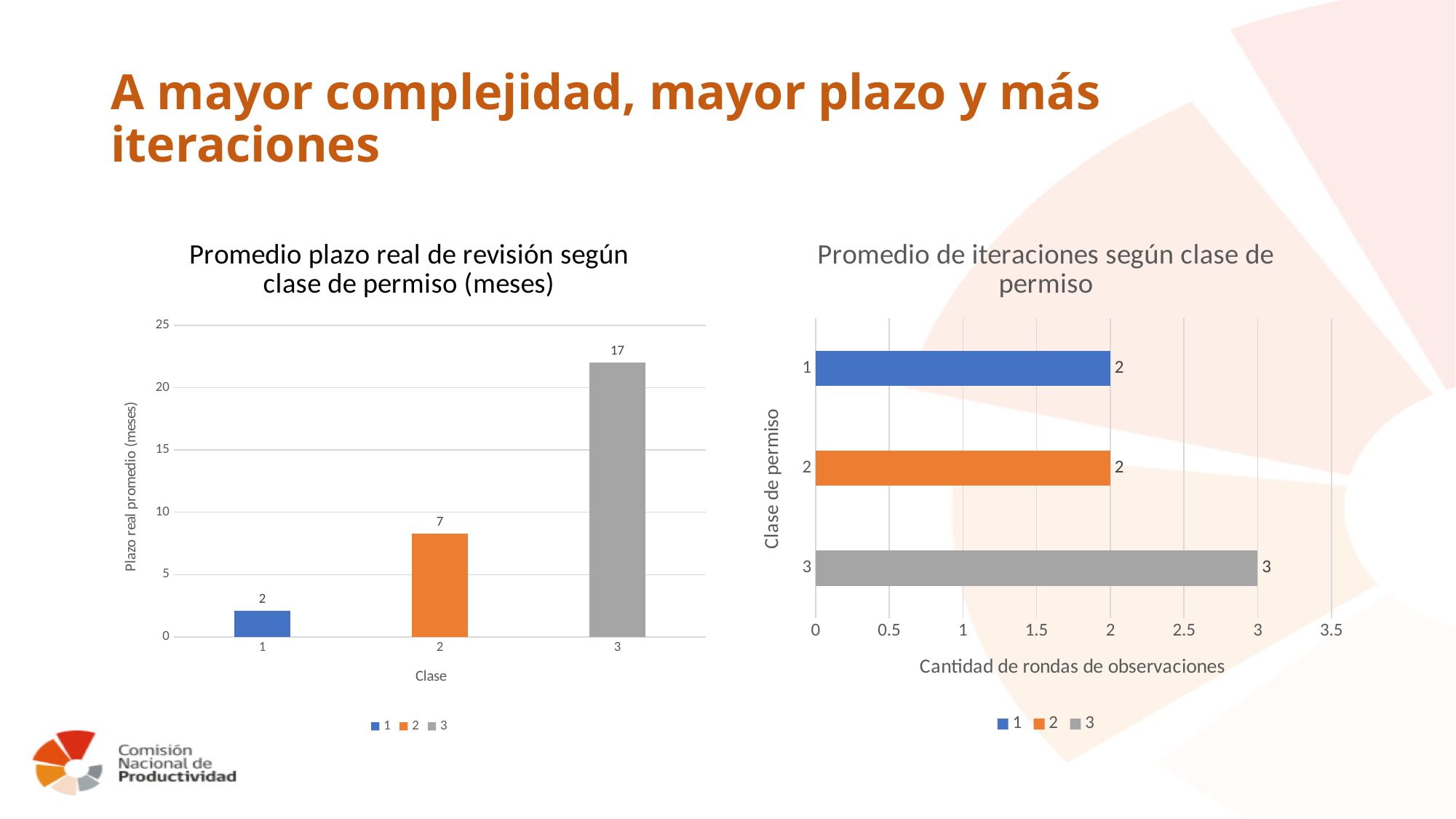
In the right chart, 'Promedio de iteraciones según clase de permiso', how many bars are plotted? 3 In the right chart, 'Promedio de iteraciones según clase de permiso', which clase de permiso has the highest value? 3 In the right chart, 'Promedio de iteraciones según clase de permiso', what is the x-axis title? Cantidad de rondas de observaciones In the left chart, 'Promedio plazo real de revisión según clase de permiso (meses)', what is the value for clase 3? 17 In the left chart, 'Promedio plazo real de revisión según clase de permiso (meses)', do the values rise or fall from clase 1 to clase 3? rise In the left chart, 'Promedio plazo real de revisión según clase de permiso (meses)', which clase has the highest value? 3 In the left chart, 'Promedio plazo real de revisión según clase de permiso (meses)', what is the value for clase 2? 7 In the right chart, 'Promedio de iteraciones según clase de permiso', what is the value for clase de permiso 3? 3 What kind of chart is the right chart, 'Promedio de iteraciones según clase de permiso'? bar chart In the left chart, 'Promedio plazo real de revisión según clase de permiso (meses)', what is the difference between the labelled values for clase 3 and clase 1? 15 In the right chart, 'Promedio de iteraciones según clase de permiso', what is the value for clase de permiso 1? 2 In the left chart, 'Promedio plazo real de revisión según clase de permiso (meses)', which clase has the lowest value? 1